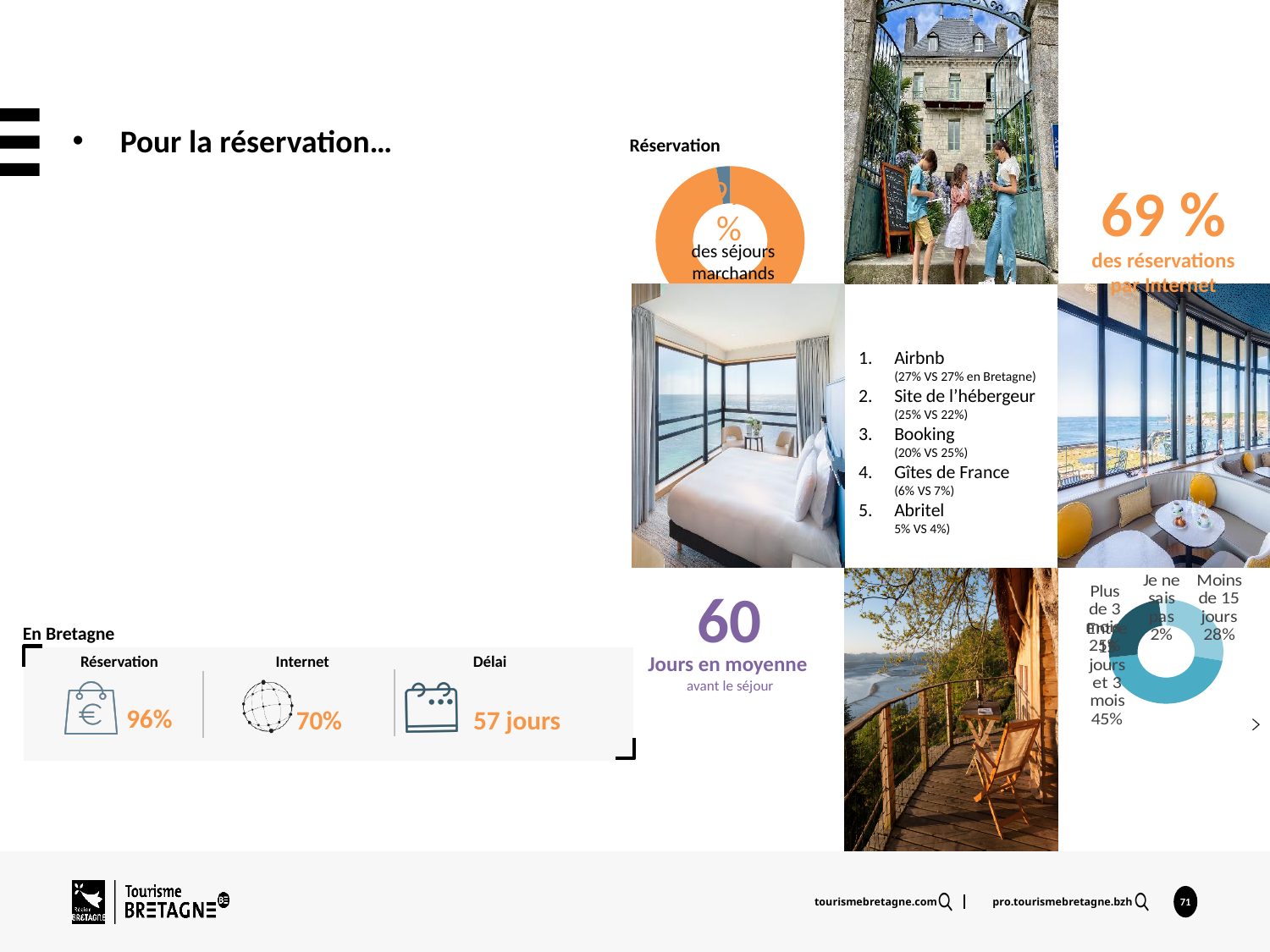
In the bottom-right pie chart, what share is shown for 'Entre 15 jours et 3 mois'? 45% What colour is the ring of the chart titled 'Réservation'? orange How many categories are shown in the bottom-right pie chart? 4 In the bottom-right pie chart, what is the difference in percentage points between 'Entre 15 jours et 3 mois' and 'Moins de 15 jours'? 17 percentage points In the bottom-right pie chart, what share is shown for 'Plus de 3 mois'? 25% In the bottom-right pie chart, which category has the largest share? Entre 15 jours et 3 mois In the bottom-right pie chart, what share is shown for 'Moins de 15 jours'? 28% What kind of chart is the chart in the bottom-right corner of the slide showing booking lead times? doughnut chart What kind of chart is the chart titled 'Réservation' near the top centre of the slide? doughnut chart In the bottom-right pie chart, what share is shown for 'Je ne sais pas'? 2% In the bottom-right pie chart, which is larger: 'Moins de 15 jours' or 'Plus de 3 mois'? Moins de 15 jours In the bottom-right pie chart, which category has the smallest share? Je ne sais pas